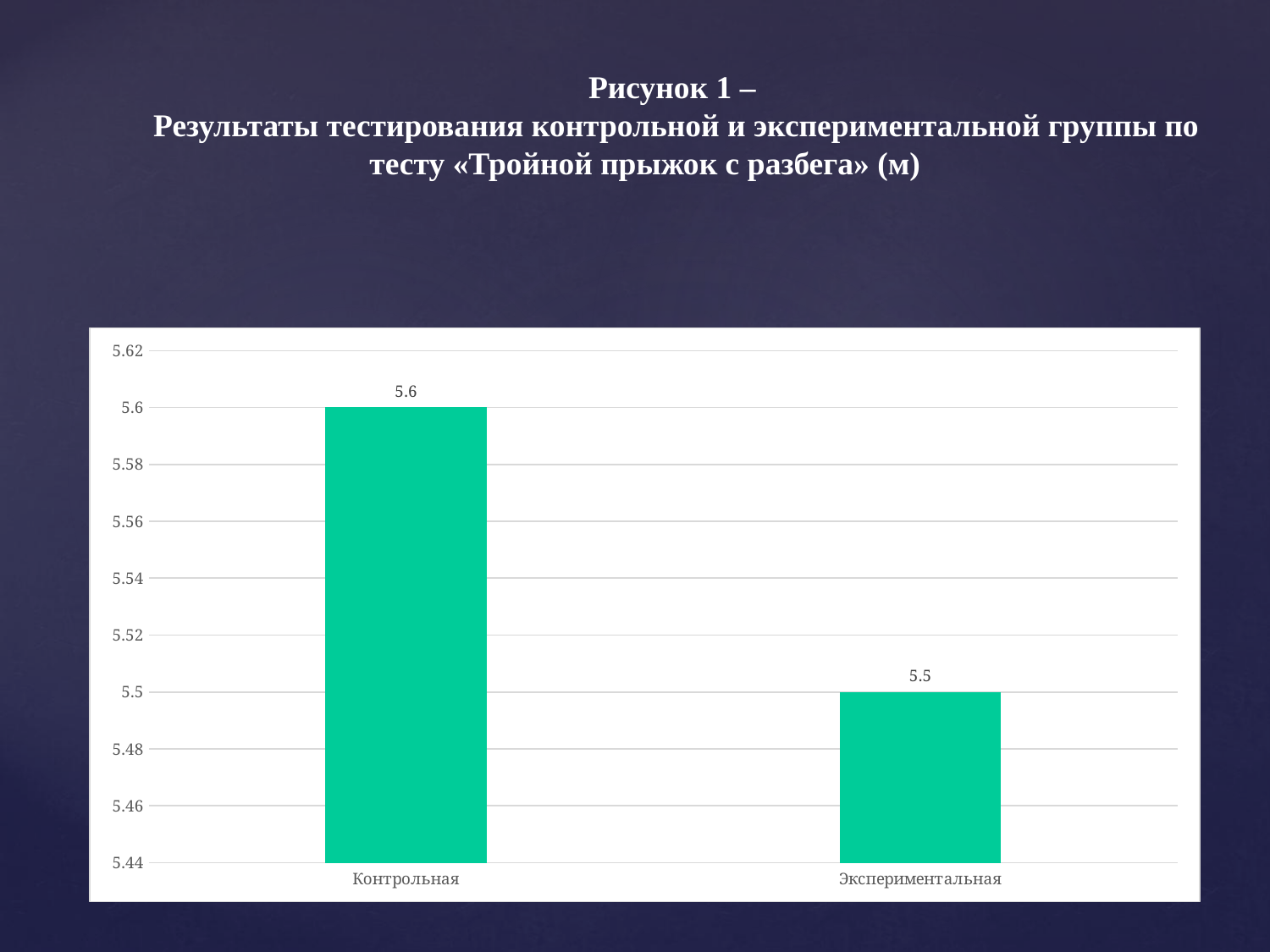
Which group has the highest value? Контрольная What is the value for Контрольная? 5.6 Which group has the lowest value? Экспериментальная What kind of chart is shown on the slide? bar chart Which is larger, the value for Контрольная or the value for Экспериментальная? Контрольная Do the values rise or fall from Контрольная to Экспериментальная? fall Is the value for Экспериментальная greater or less than 5.52? less Is the value for Контрольная greater or less than 5.58? greater What is the value for Экспериментальная? 5.5 What is the difference between the values for Контрольная and Экспериментальная? 0.1 What is the lowest value shown on the y axis? 5.44 How many categories are shown on the x axis? 2